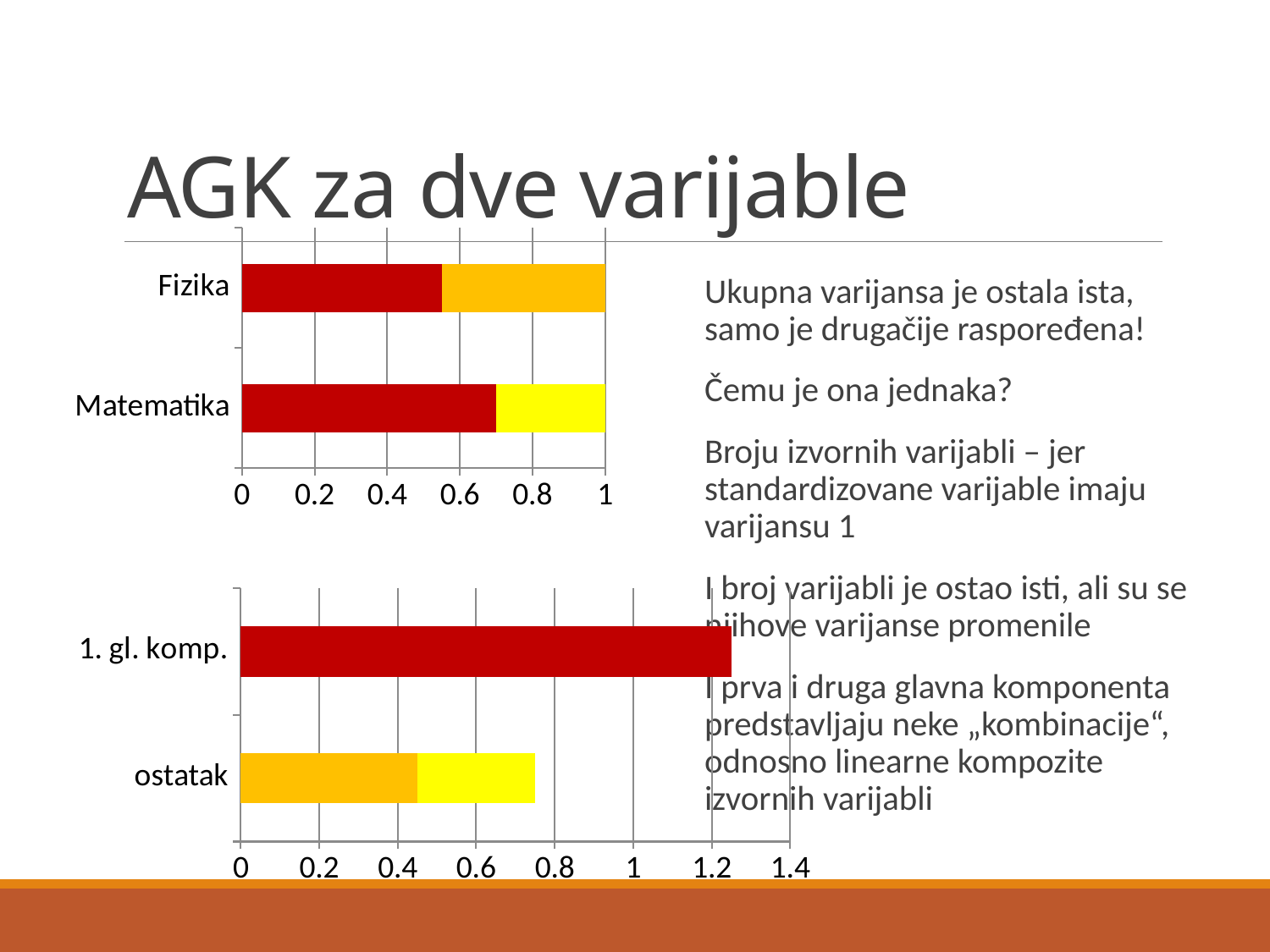
In the top chart, is the red segment for Matematika greater or less than 0.6? greater In the top chart, what is the total length of the stacked bar for Matematika? 1 How many categories does the top chart show? 2 In the bottom chart, is the orange segment of the ostatak bar greater or less than 0.4? greater In the bottom chart, is the value for 1. gl. komp. greater or less than 1? greater What kind of chart is the top chart on the slide? bar chart What is the highest tick value shown on the x axis of the bottom chart? 1.4 How many categories does the bottom chart show? 2 In the bottom chart, which category has the longer bar? 1. gl. komp. In the top chart, what is the total length of the stacked bar for Fizika? 1